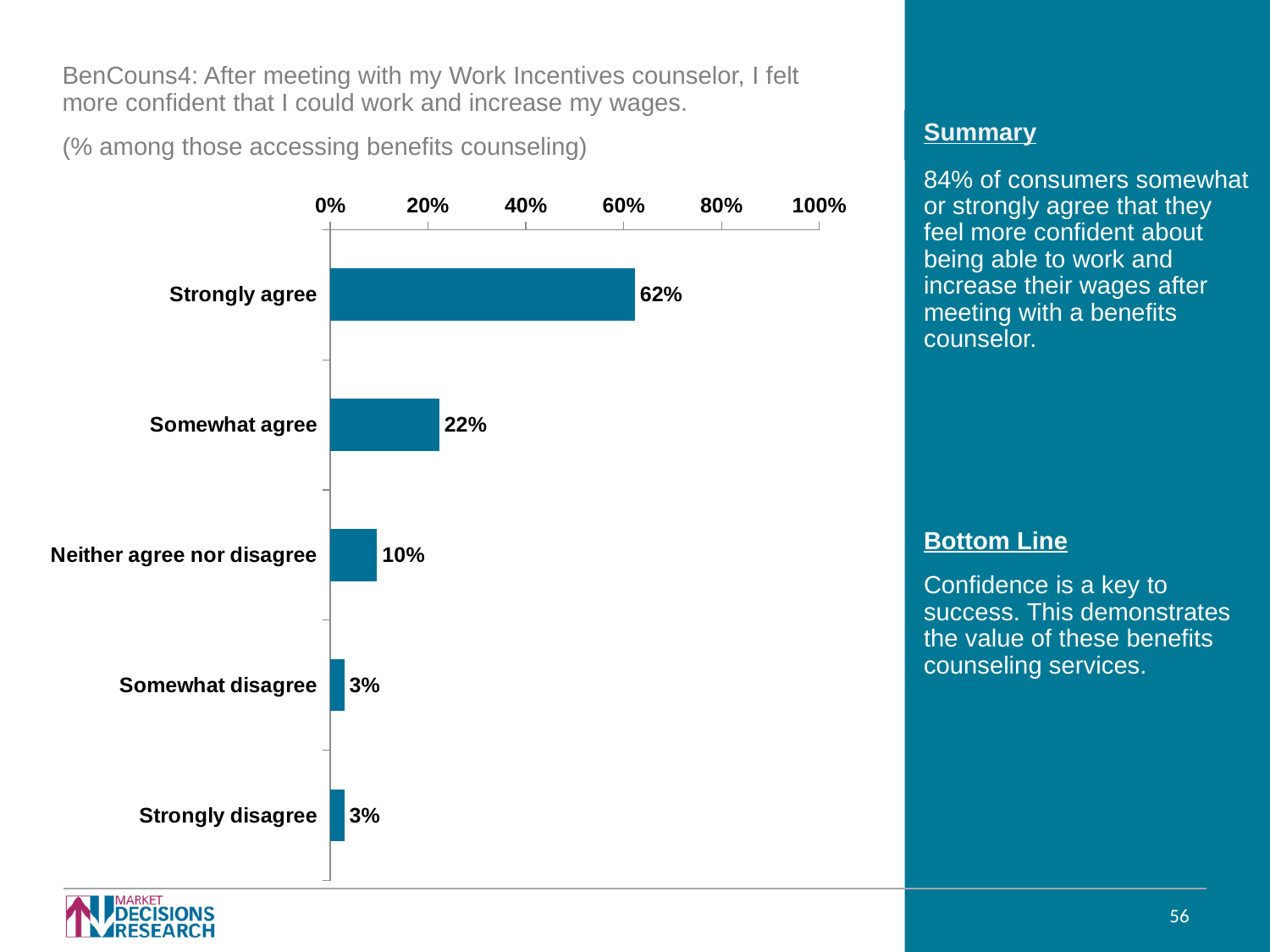
Which response category has the highest percentage? Strongly agree What type of chart is shown on the slide? Bar chart How many response categories are shown in the chart? 5 What is the highest value labeled on the percentage axis of the chart? 100% Is the value for Strongly agree greater or less than 60%? greater What is the difference in percentage points between Strongly agree and Somewhat agree? 40 What is the value shown for Somewhat agree? 22% What is the combined percentage of Somewhat disagree and Strongly disagree? 6% What percentage of respondents neither agree nor disagree? 10% Which is larger, the value for Somewhat agree or the value for Neither agree nor disagree? Somewhat agree What is the value shown for Strongly disagree? 3% What percentage of respondents strongly agree that they felt more confident they could work and increase their wages? 62%